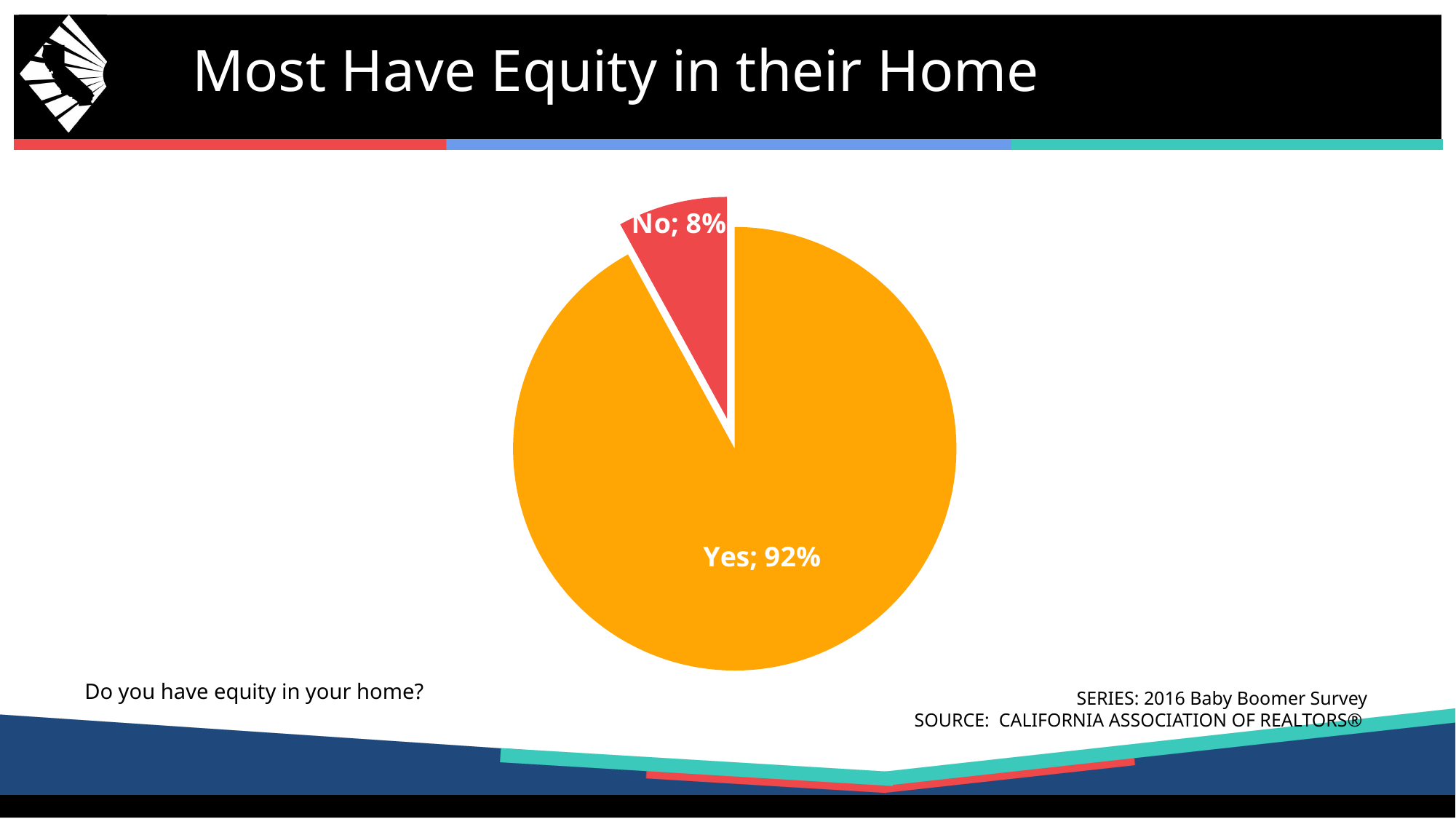
How many slices does the pie chart have? 2 What is the difference in percentage points between the Yes and No slices? 84 What survey question does the pie chart answer, as printed on the slide? Do you have equity in your home? What colour is the Yes slice of the pie chart? orange Which is larger, the Yes slice or the No slice? Yes Which slice of the pie is the smallest? No Which slice of the pie is the largest? Yes What share of respondents answered No to having equity in their home? 8% What is the total of the two slices shown in the pie chart? 100% What kind of chart is shown on the slide? pie chart What share of respondents answered Yes to having equity in their home? 92%